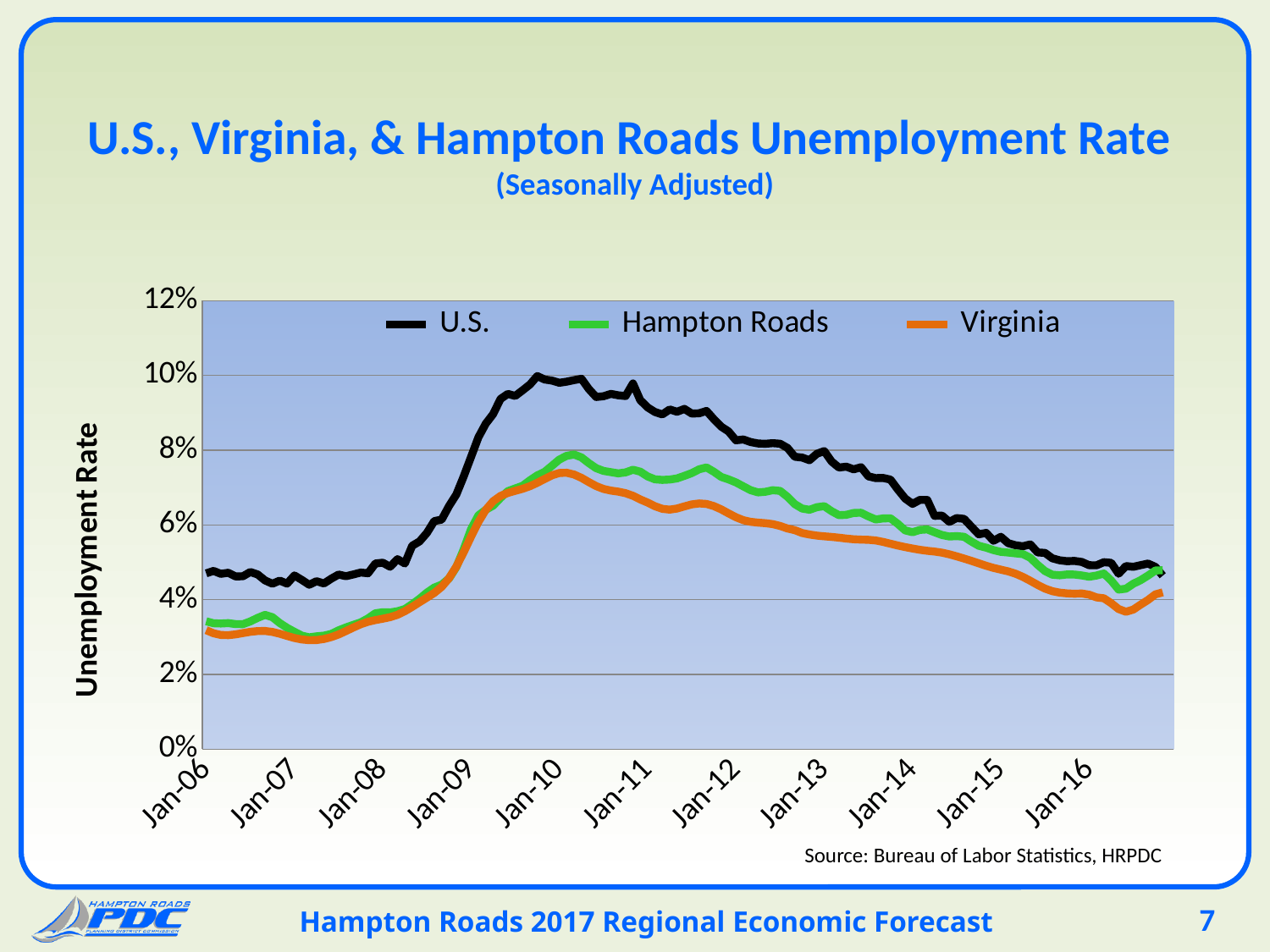
At Jan-12, which is larger, the U.S. rate or the Virginia rate? U.S. What kind of chart is shown on the slide? Line chart Is the Hampton Roads unemployment rate at Jan-10 greater or less than 6%? greater Does the U.S. unemployment rate rise or fall between Jan-10 and Jan-16? Fall How many series does the legend list? 3 Which series stays lowest across the chart? Virginia Is the Virginia unemployment rate at Jan-07 greater or less than 4%? less What is the label on the vertical axis? Unemployment Rate Which series reaches the highest peak on the chart? U.S. Which series are listed in the legend? U.S., Hampton Roads, Virginia How many year labels are shown on the x axis? 11 Is the U.S. unemployment rate at Jan-10 greater or less than 8%? greater